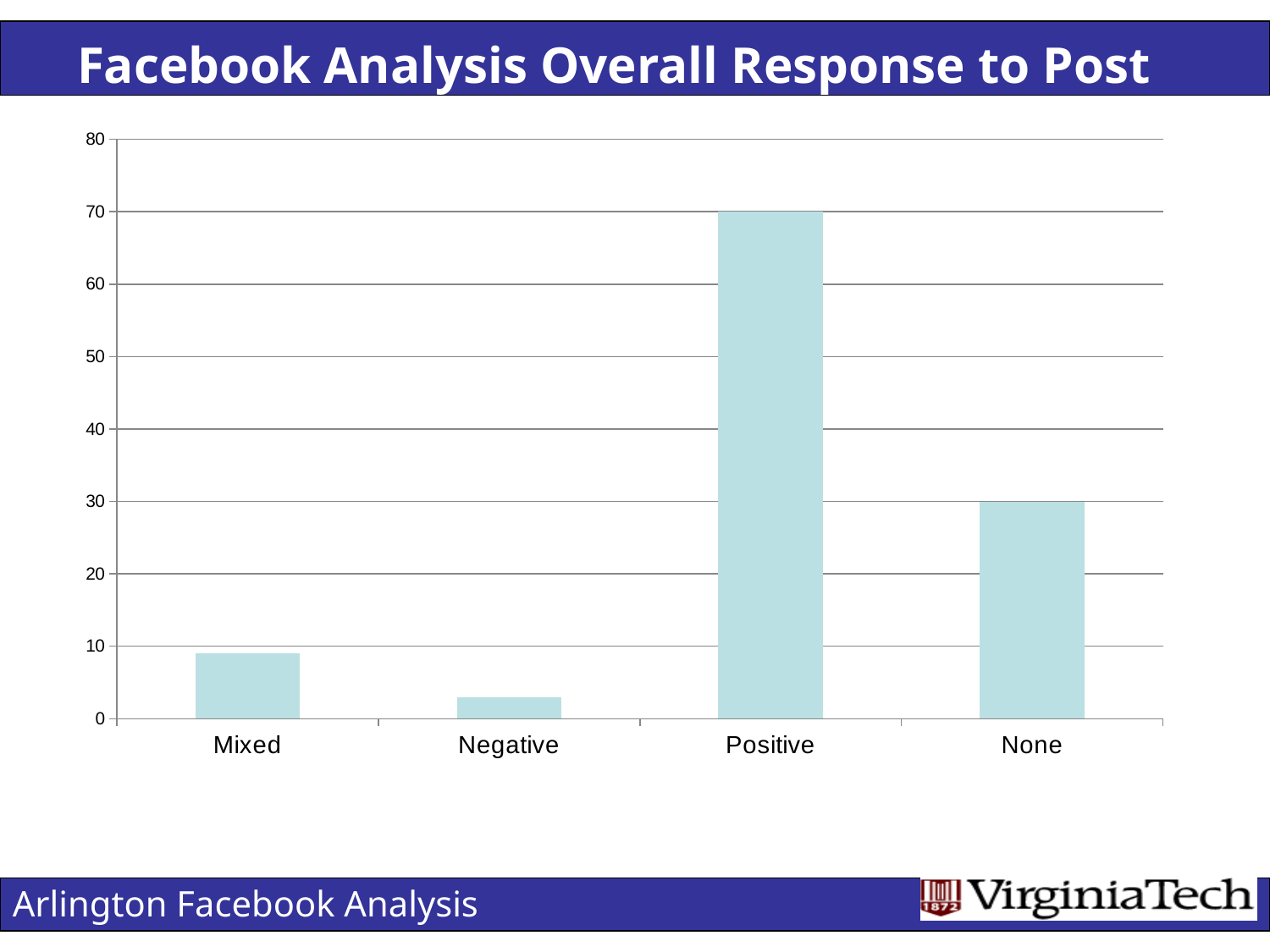
What is the value for Positive? 70 Is the value for Mixed greater or less than 10? less Which category has the highest value? Positive What is the value for None? 30 How many categories are shown on the x axis of the chart? 4 Is the value for Negative greater or less than 10? less Which is larger, the value for None or the value for Mixed? None Which is larger, the value for Mixed or the value for Negative? Mixed Which category has the lowest value? Negative What is the difference between the values for Positive and None? 40 What kind of chart is shown on the slide? bar chart What is the title of the slide containing the chart? Facebook Analysis Overall Response to Post